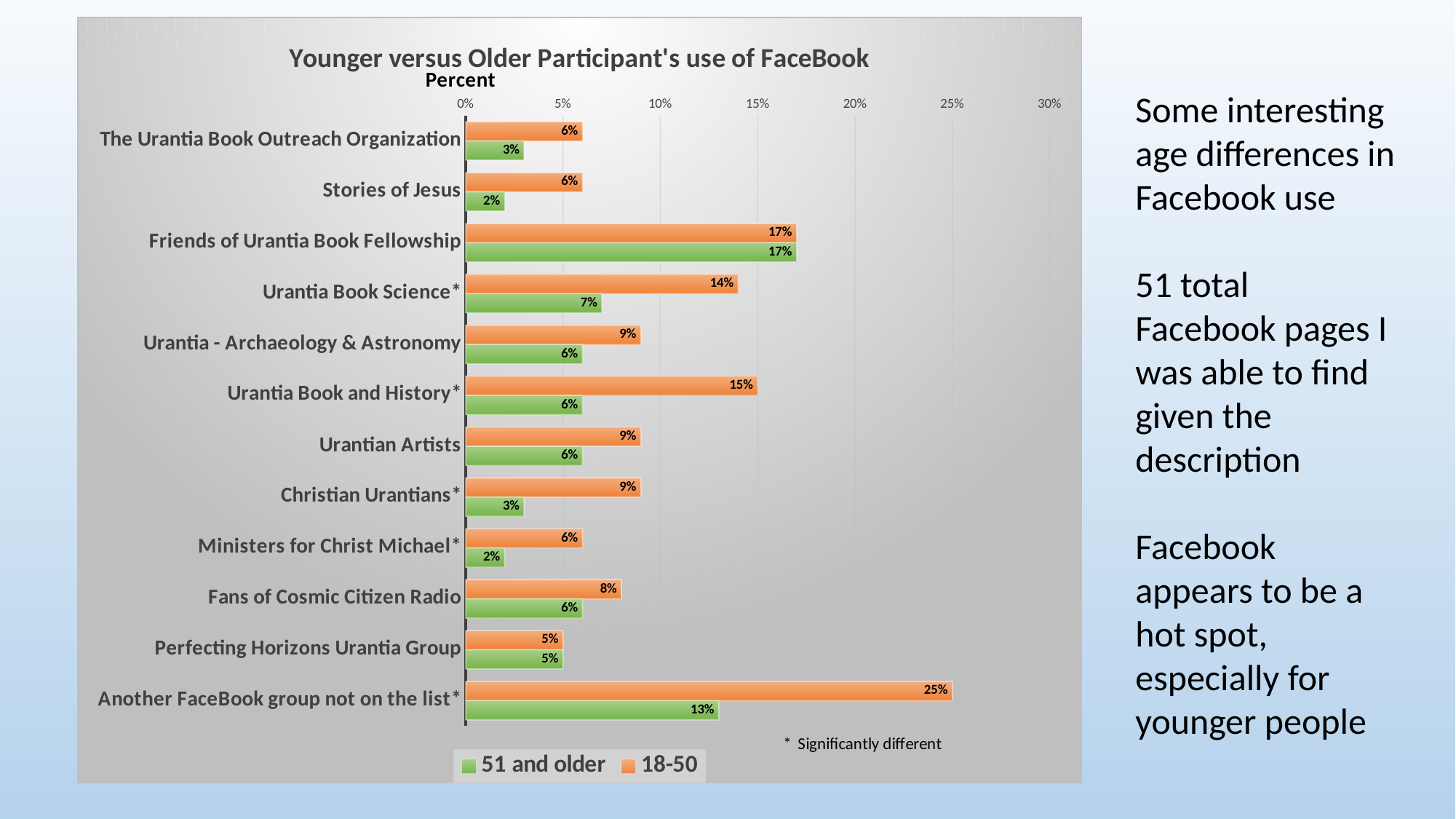
Which category has the highest value for the 18-50 series? Another FaceBook group not on the list* What is the difference between the 18-50 and 51 and older values for Urantia Book and History*? 9% How many categories are shown on the chart? 12 What is the title of the chart? Younger versus Older Participant's use of FaceBook What is the value for the 18-50 series for Urantia Book Science*? 14% What is the difference between the 18-50 and 51 and older values for Christian Urantians*? 6% Which category has the highest value for the 51 and older series? Friends of Urantia Book Fellowship What is the value for the 51 and older series for Stories of Jesus? 2% What kind of chart is shown on the slide? Bar chart Which series has the larger value for Ministers for Christ Michael*, 18-50 or 51 and older? 18-50 How many series does the legend list? 2 What is the value for the 51 and older series for Another FaceBook group not on the list*? 13%